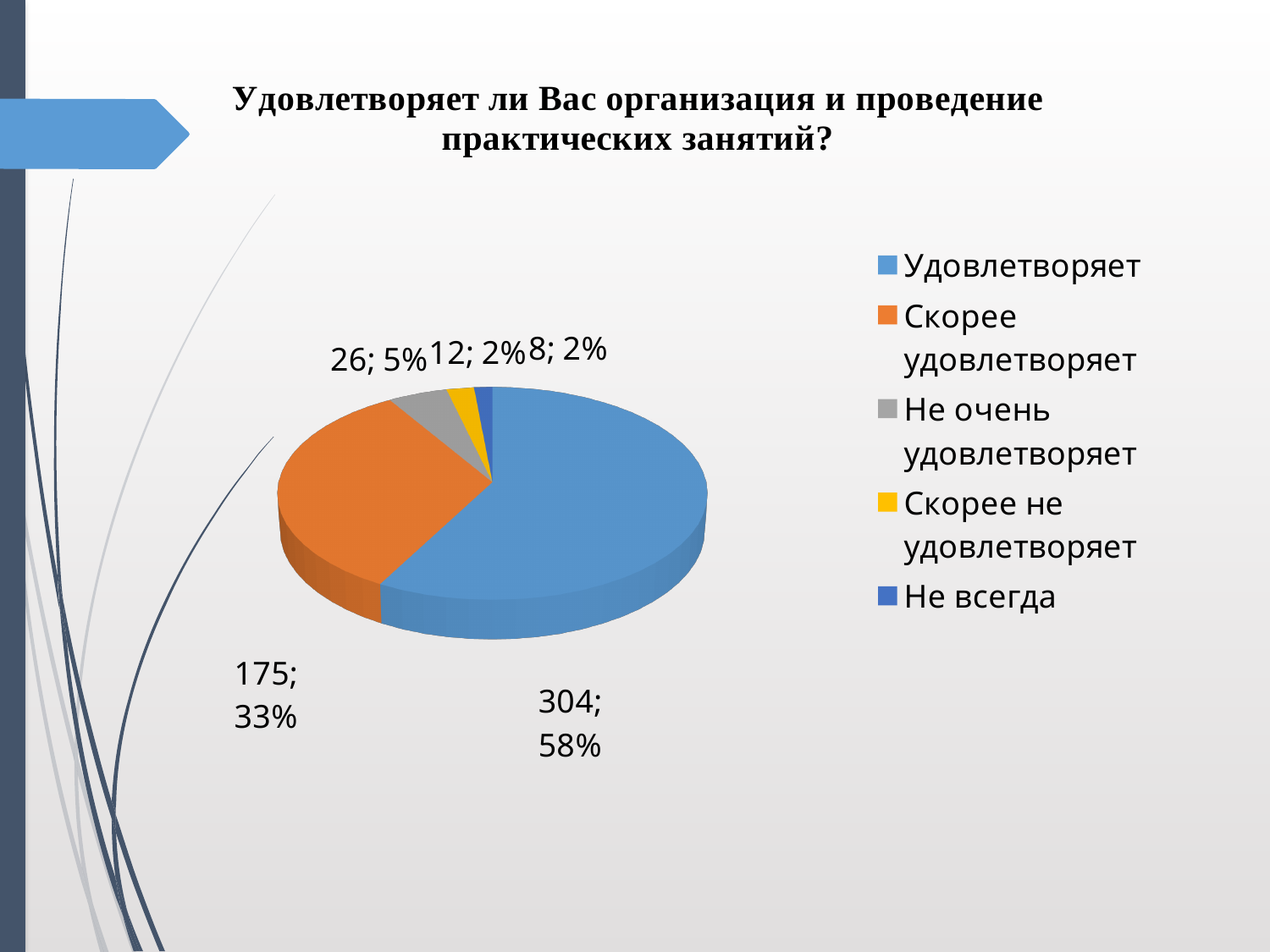
Which is larger: the value for "Не очень удовлетворяет" or the value for "Скорее не удовлетворяет"? Не очень удовлетворяет Which category has the smallest slice in the pie chart? Не всегда What is the value for "Скорее не удовлетворяет"? 12 What is the value for "Не очень удовлетворяет"? 26 What percentage share does "Скорее удовлетворяет" have in the pie chart? 33% What kind of chart is shown on the slide? Pie chart Which category has the largest slice in the pie chart? Удовлетворяет What colour is the slice for "Скорее удовлетворяет"? Orange What is the value for "Не всегда"? 8 What is the difference between the values for "Удовлетворяет" and "Скорее удовлетворяет"? 129 What is the value for "Удовлетворяет"? 304 How many categories does the legend of the pie chart list? 5